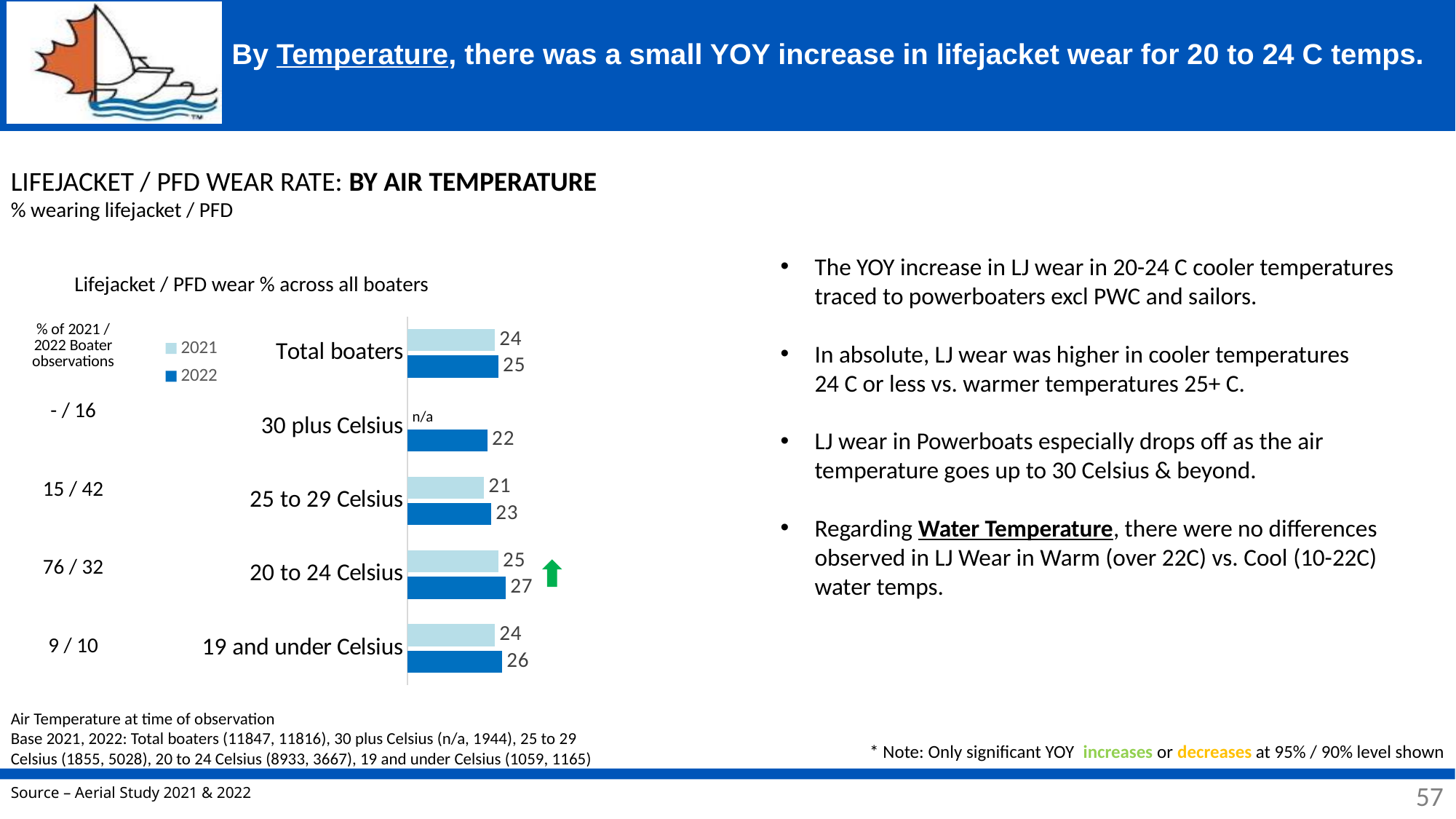
What is the difference between the 2022 values for 19 and under Celsius and 25 to 29 Celsius? 3 How many categories are shown on the chart? 5 Which is larger: the 2022 value for 19 and under Celsius or the 2022 value for 25 to 29 Celsius? 19 and under Celsius What is the 2022 lifejacket/PFD wear % for Total boaters? 25 Which temperature category has the lowest 2022 lifejacket/PFD wear %? 30 plus Celsius What type of chart is shown on the slide? Bar chart What is the 2021 value shown for 30 plus Celsius? n/a How many series does the legend list? 2 Which temperature category has the highest 2022 lifejacket/PFD wear %? 20 to 24 Celsius What is the 2021 lifejacket/PFD wear % for 25 to 29 Celsius? 21 What is the difference between the 2022 and 2021 values for 20 to 24 Celsius? 2 What is the 2022 lifejacket/PFD wear % for 30 plus Celsius? 22